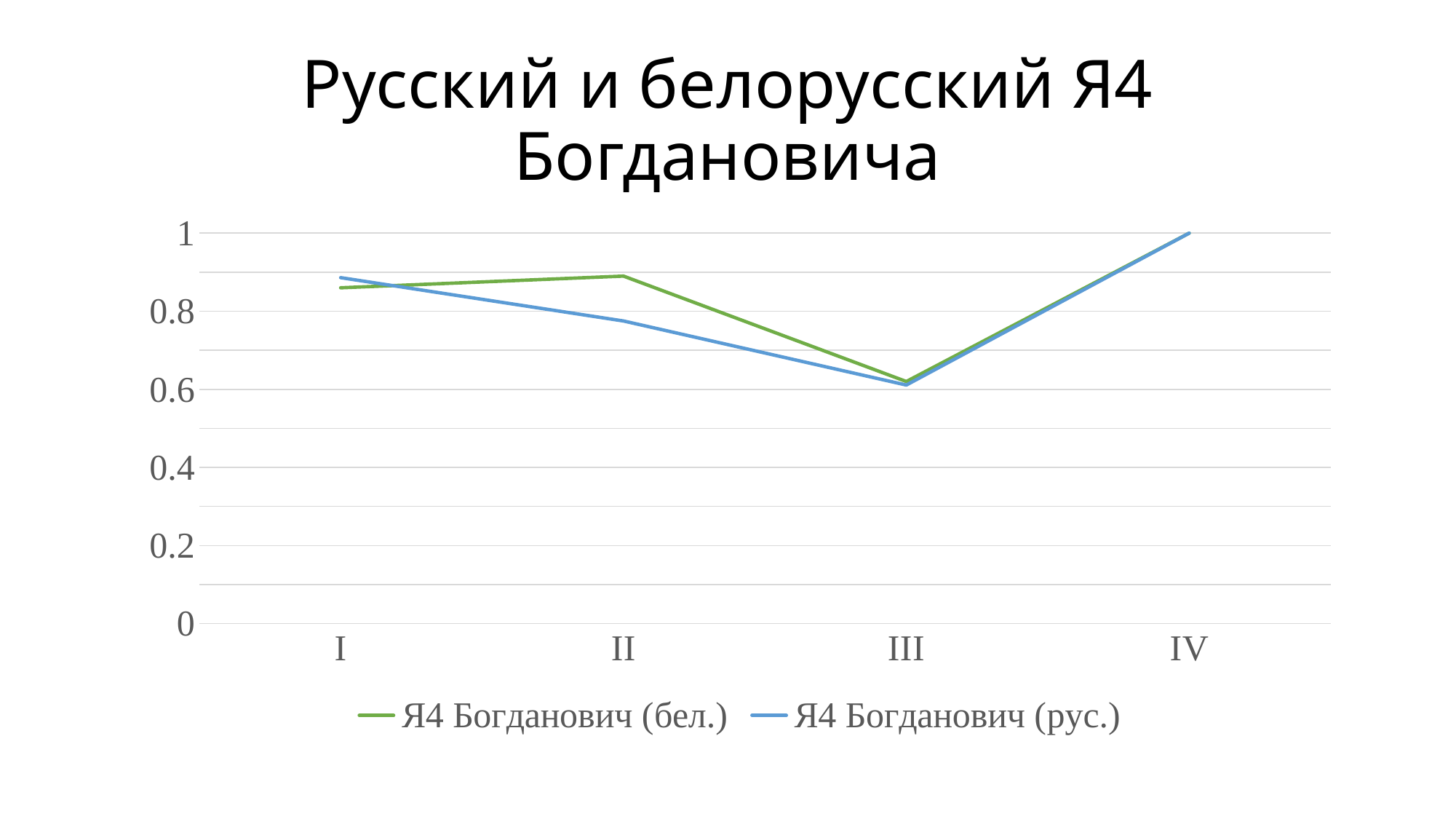
Which colour is used for the Я4 Богданович (рус.) line? blue Is the value for Я4 Богданович (рус.) at II greater or less than 0.8? less What is the value of Я4 Богданович (рус.) at IV? 1 What kind of chart is shown on the slide? line chart At II, which series has the larger value, Я4 Богданович (бел.) or Я4 Богданович (рус.)? Я4 Богданович (бел.) How many categories are shown on the x axis? 4 At which category is Я4 Богданович (рус.) highest? IV How many series does the legend list? 2 Is the value for Я4 Богданович (бел.) at II greater or less than 0.8? greater What is the value of Я4 Богданович (бел.) at IV? 1 Do the values of Я4 Богданович (рус.) rise or fall from III to IV? rise At which category is Я4 Богданович (бел.) lowest? III